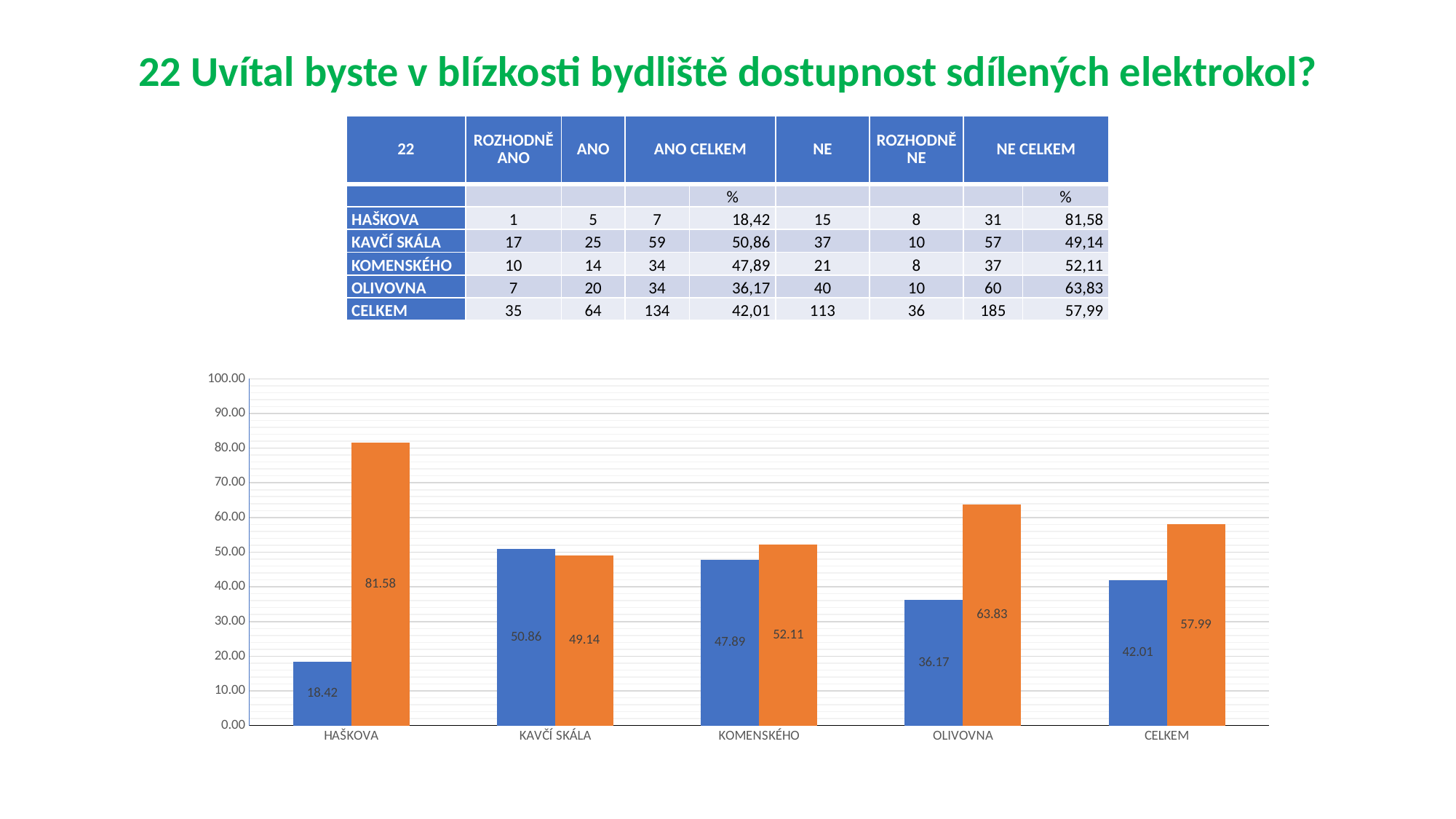
What is the value of the blue bar for HAŠKOVA? 18.42 What is the difference between the orange and blue bars for HAŠKOVA? 63.16 What kind of chart is shown on the slide? bar chart What is the value of the orange bar for CELKEM? 57.99 What is the value of the orange bar for OLIVOVNA? 63.83 Which category has the lowest blue bar? HAŠKOVA For KOMENSKÉHO, which bar is larger, the blue or the orange? orange Which category has the highest orange bar? HAŠKOVA Which category has the highest blue bar? KAVČÍ SKÁLA What is the difference between the orange and blue bars for OLIVOVNA? 27.66 How many categories are shown on the x axis of the chart? 5 Is the orange bar for HAŠKOVA greater or less than 80.00? greater